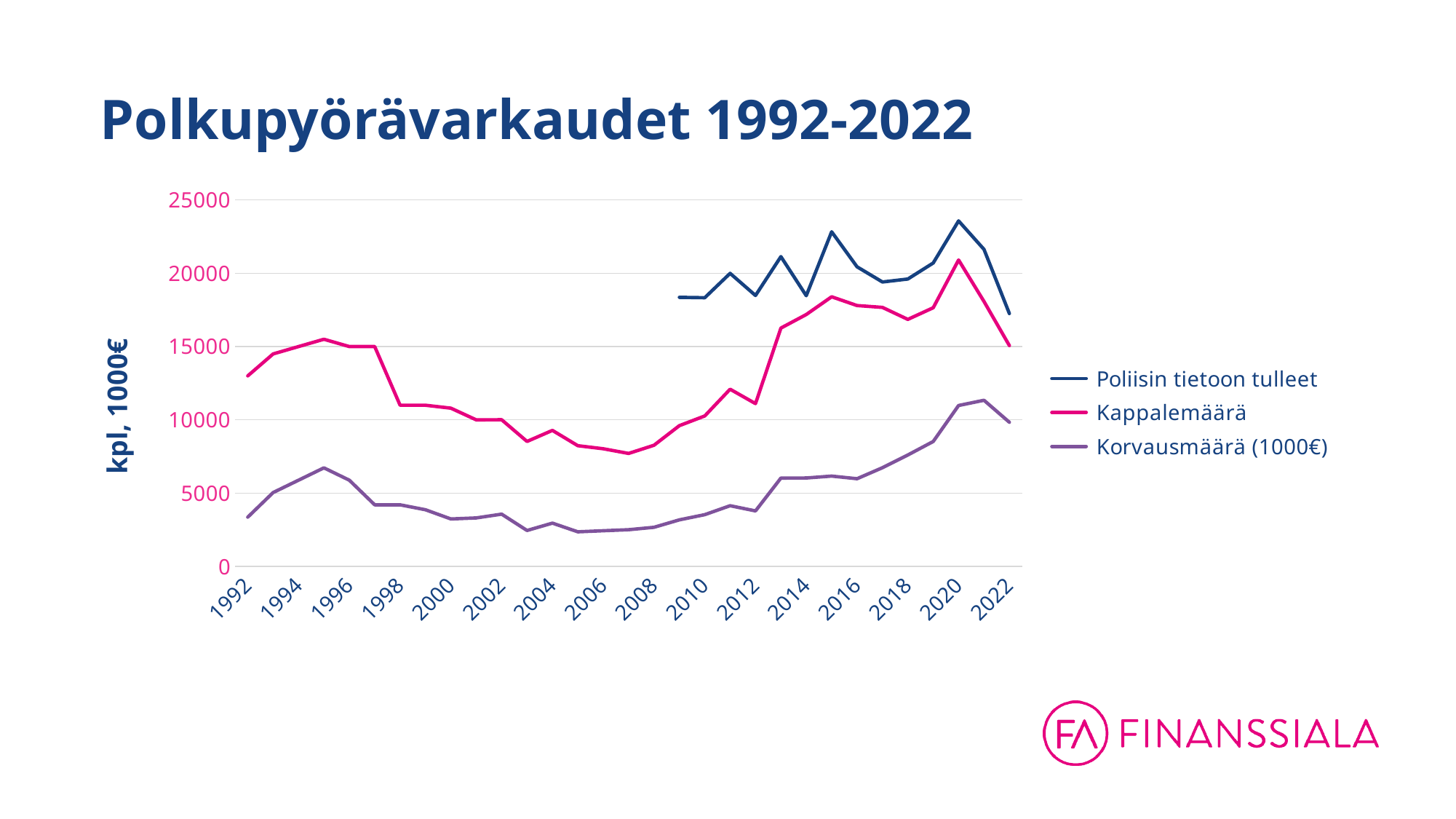
What is the label on the vertical axis? kpl, 1000€ Is the value for Kappalemäärä in 2007 greater or less than 10000? less What is the title of the chart? Polkupyörävarkaudet 1992-2022 Is the value for Poliisin tietoon tulleet in 2015 greater or less than 20000? greater Is the value for Korvausmäärä (1000€) in 2006 greater or less than 5000? less Does the Kappalemäärä series rise or fall from 2020 to 2022? fall In 2010, which is larger: Poliisin tietoon tulleet or Kappalemäärä? Poliisin tietoon tulleet In which year does the Poliisin tietoon tulleet series reach its highest value? 2020 What kind of chart is shown on the slide? line chart In which year does the Kappalemäärä series reach its highest value? 2020 How many series does the legend list? 3